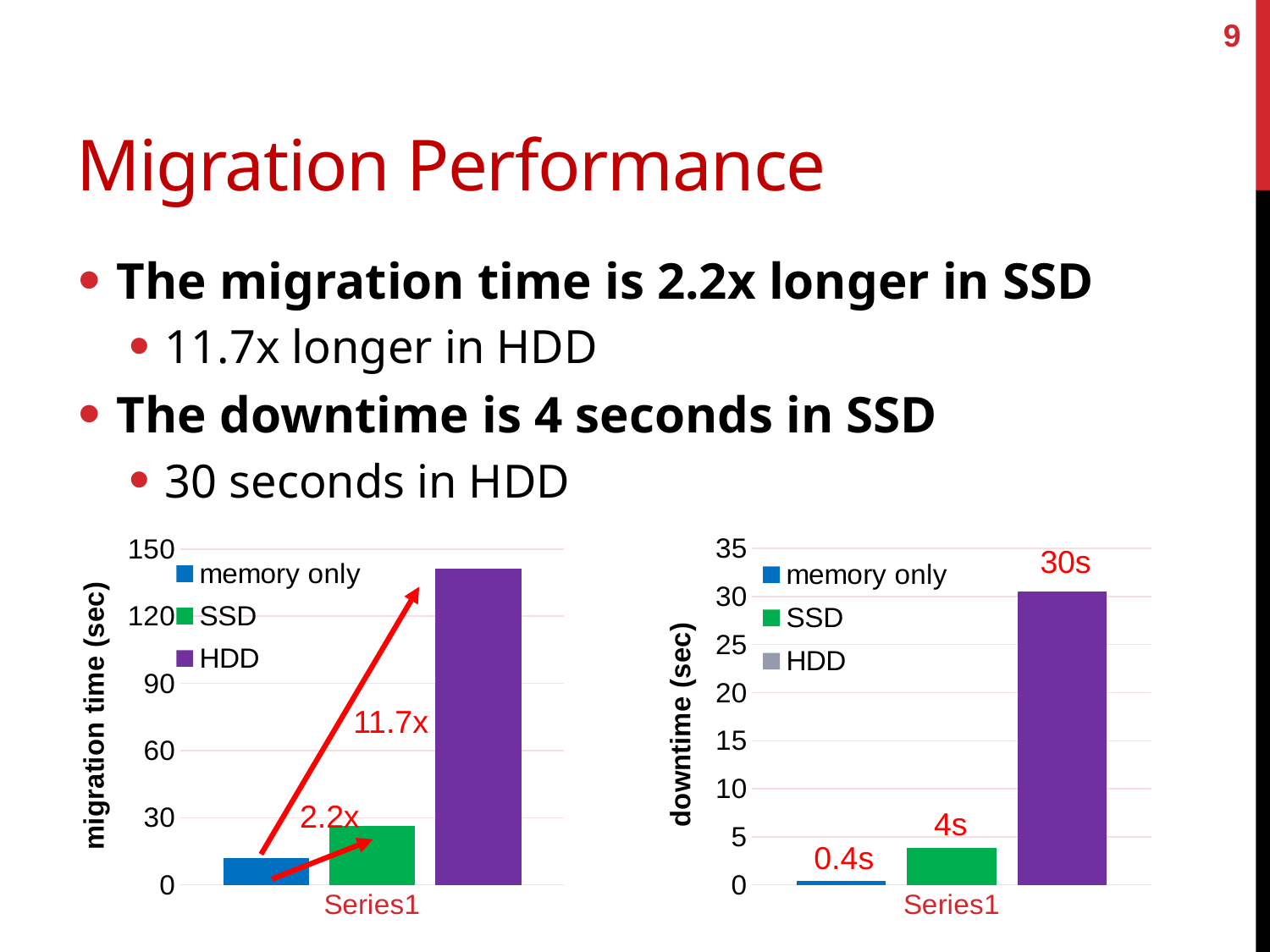
On the right chart (downtime), how much longer is the HDD downtime than the SSD downtime? 26s On the left chart (migration time), which is larger, the migration time for SSD or for memory only? SSD On the right chart (downtime), what is the downtime for memory only? 0.4s On the left chart (migration time), is the migration time for HDD greater or less than 120? greater On the left chart (migration time), is the migration time for SSD greater or less than 30? less What kind of chart is the right chart (downtime)? bar chart On the right chart (downtime), what is the downtime for SSD? 4s How many series does the legend of the left chart (migration time) list? 3 On the left chart (migration time), which series has the highest migration time? HDD On the right chart (downtime), which series has the highest downtime? HDD On the right chart (downtime), what is the downtime for HDD? 30s On the right chart (downtime), which series has the lowest downtime? memory only